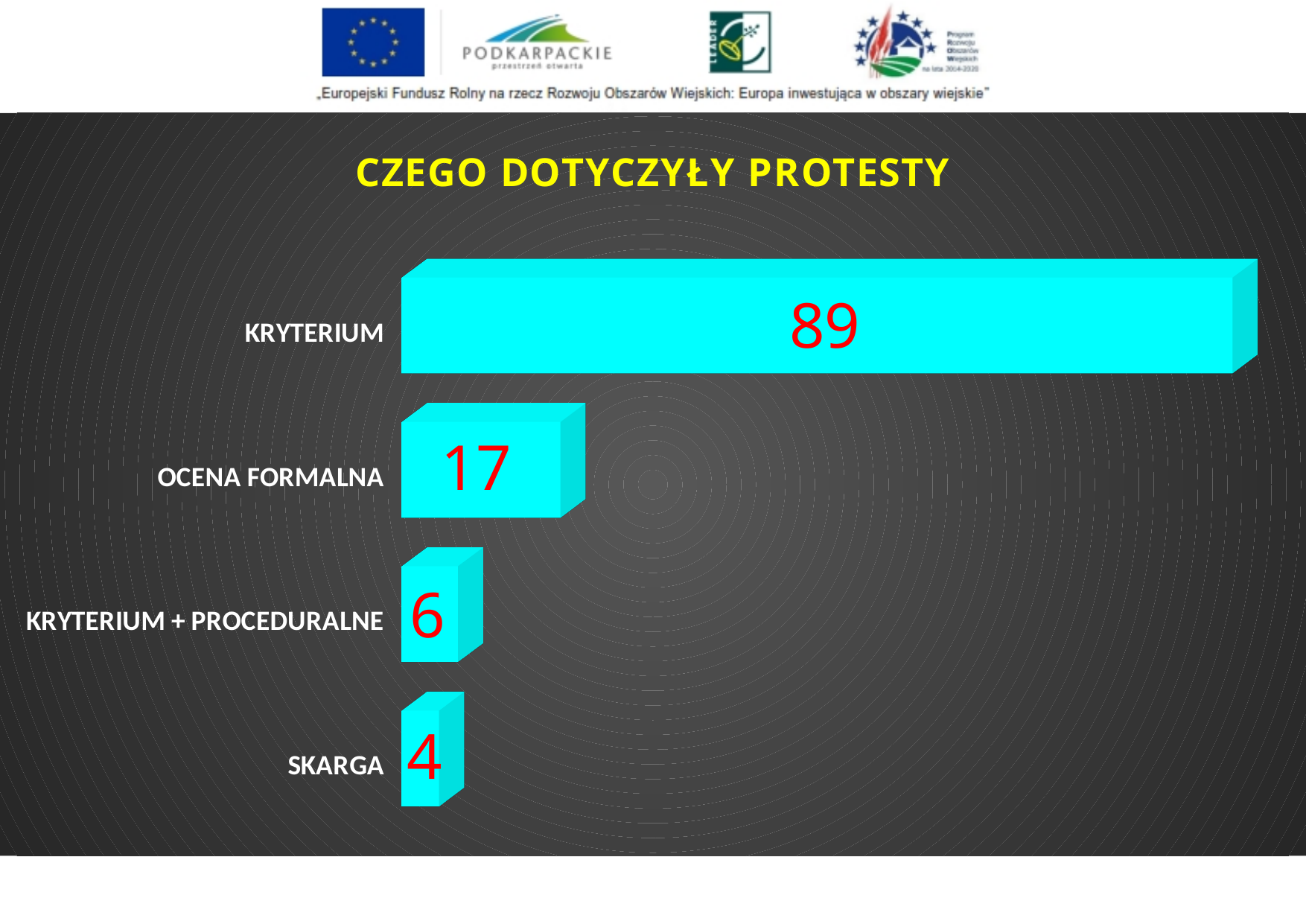
What is the value for SKARGA? 4 Which category has the lowest value? SKARGA What is the difference between the values for KRYTERIUM + PROCEDURALNE and SKARGA? 2 Which category has the highest value? KRYTERIUM How many categories are shown in the chart? 4 What is the value for KRYTERIUM + PROCEDURALNE? 6 What is the title of the chart? CZEGO DOTYCZYŁY PROTESTY What is the value for OCENA FORMALNA? 17 Which is larger, the value for OCENA FORMALNA or the value for KRYTERIUM + PROCEDURALNE? OCENA FORMALNA What is the value for KRYTERIUM? 89 What is the difference between the values for KRYTERIUM and OCENA FORMALNA? 72 What kind of chart is shown on the slide? bar chart